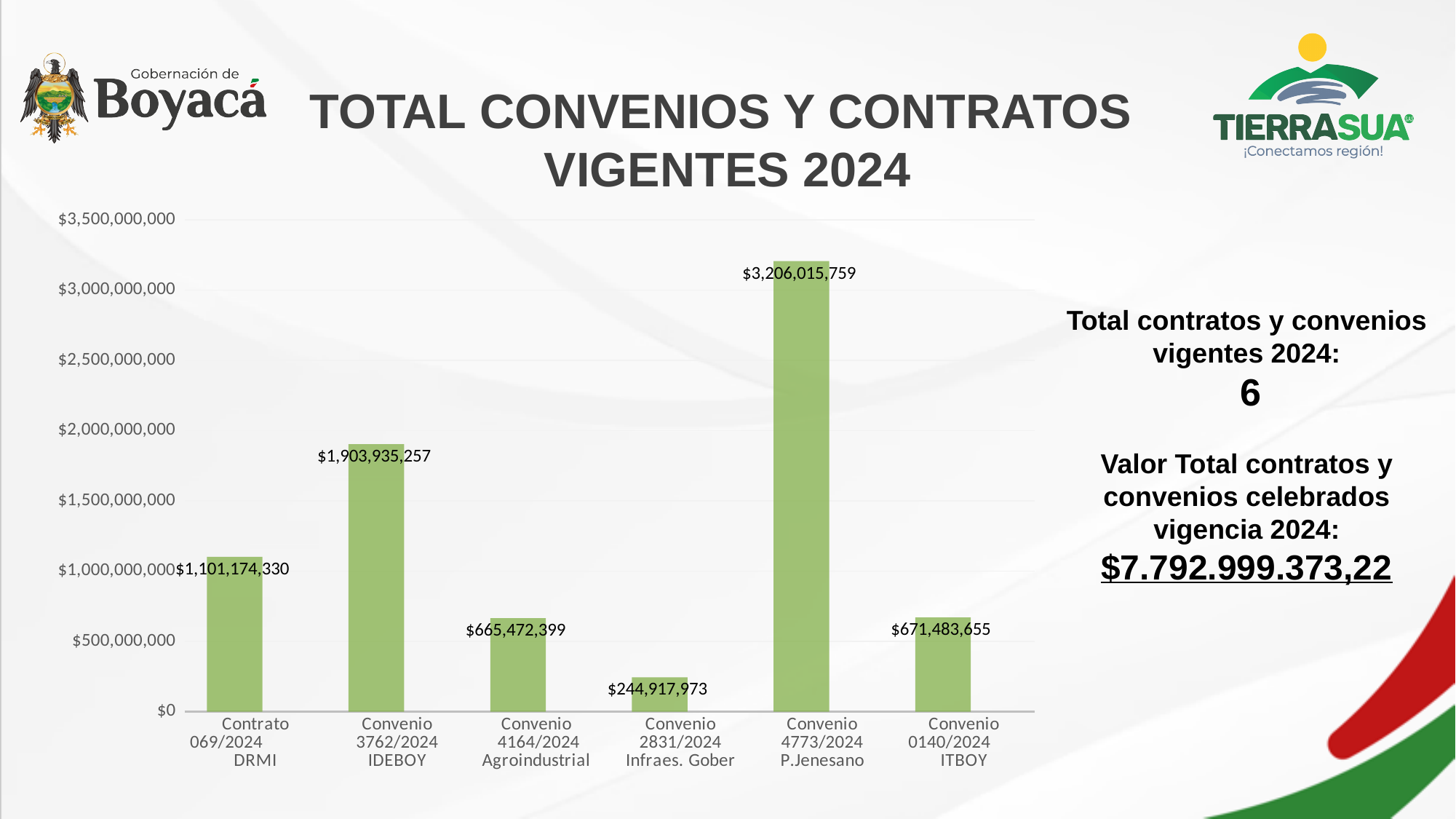
Which category has the highest value? Convenio 4773/2024 P.Jenesano How many categories are shown in the chart? 6 What is the value for Convenio 4773/2024 P.Jenesano? $3,206,015,759 Which is larger, the value for Convenio 3762/2024 IDEBOY or the value for Contrato 069/2024 DRMI? Convenio 3762/2024 IDEBOY What is the difference between the values for Convenio 4773/2024 P.Jenesano and Convenio 3762/2024 IDEBOY? $1,302,080,502 What is the value for Convenio 2831/2024 Infraes. Gober? $244,917,973 What is the value for Convenio 0140/2024 ITBOY? $671,483,655 Is the value for Contrato 069/2024 DRMI greater or less than $1,000,000,000? greater What kind of chart is shown on the slide? bar chart What is the title of the chart? TOTAL CONVENIOS Y CONTRATOS VIGENTES 2024 Which category has the lowest value? Convenio 2831/2024 Infraes. Gober What is the value for Contrato 069/2024 DRMI? $1,101,174,330